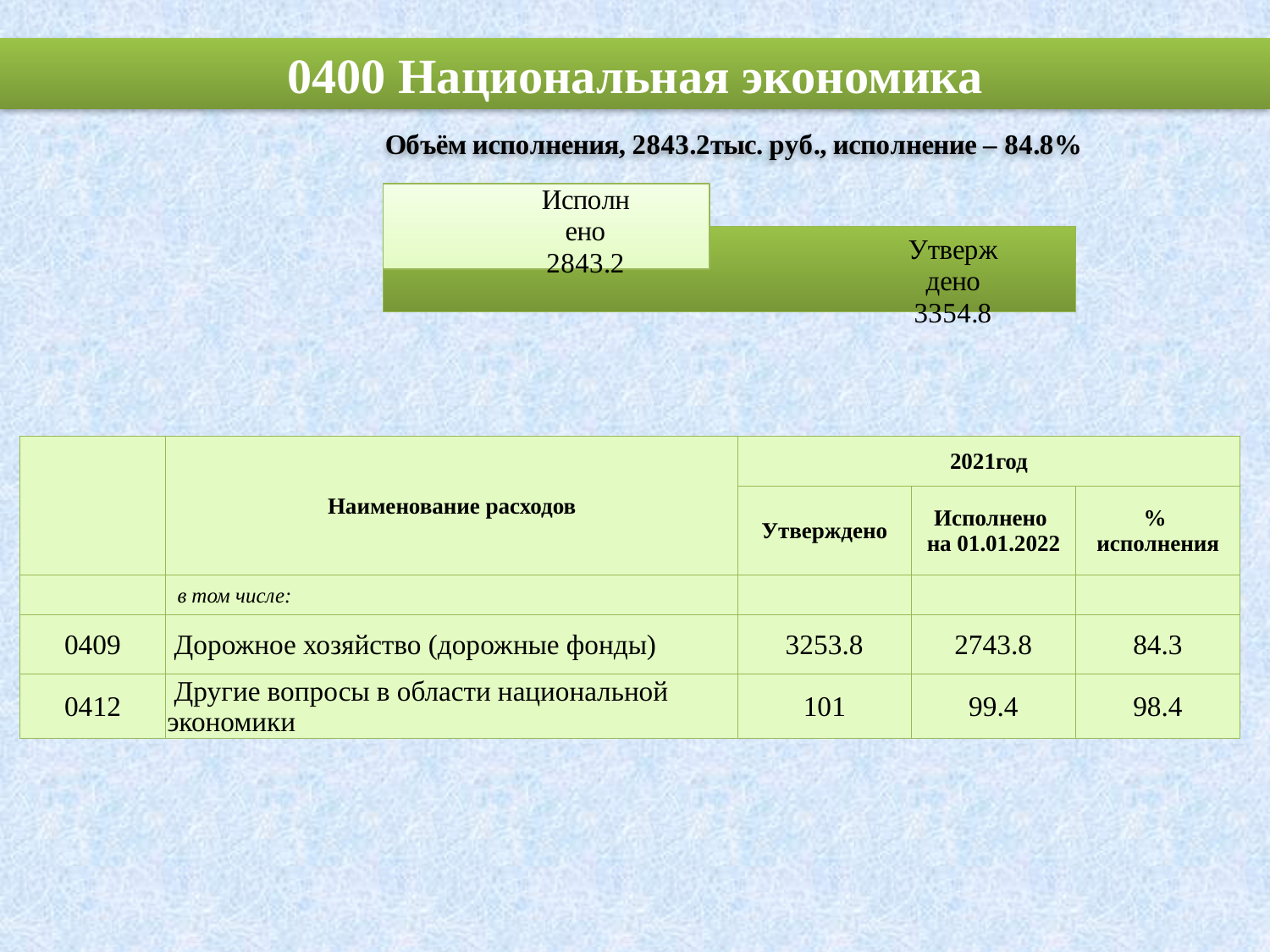
Which bar in the chart has the higher value, "Исполнено" or "Утверждено"? Утверждено What colour is the "Утверждено" bar in the chart? Dark green What is the difference between the "Утверждено" and "Исполнено" values in the chart? 511.6 What colour is the "Исполнено" bar in the chart? Light green What is the value of the bar labelled "Утверждено" in the chart? 3354.8 Which bar in the chart has the highest value? Утверждено Which bar in the chart has the lowest value? Исполнено What kind of chart is shown on the slide? Bar chart What is the value of the bar labelled "Исполнено" in the chart? 2843.2 How many bars are shown in the chart? 2